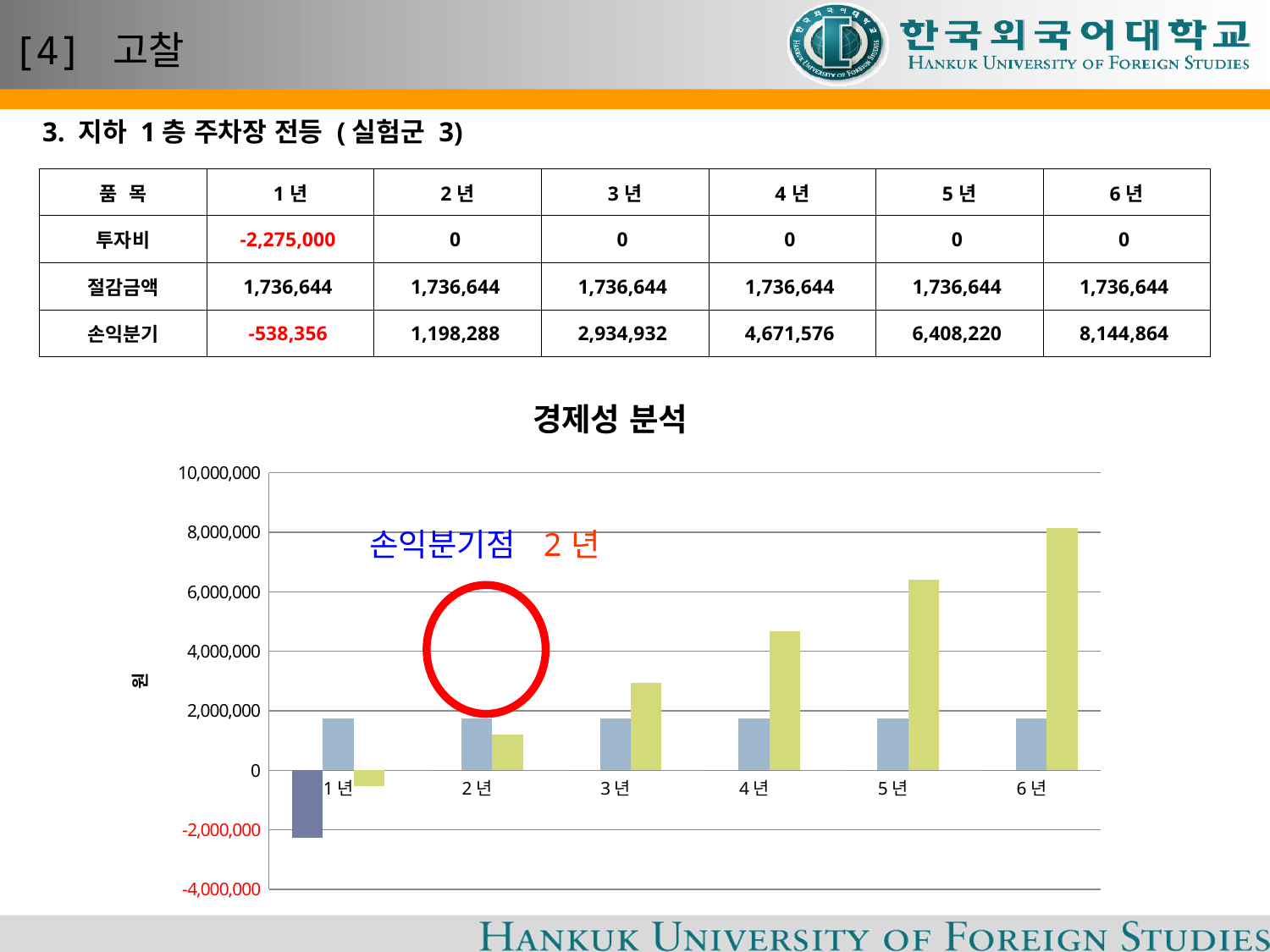
In the 경제성 분석 chart, is the green bar for 6 년 greater or less than 6,000,000? greater In the 경제성 분석 chart, is the green bar for 5 년 greater or less than 4,000,000? greater According to the annotation on the 경제성 분석 chart, at which year is the 손익분기점 (break-even point)? 2 년 In the 경제성 분석 chart, is the green bar for 3 년 greater or less than 4,000,000? less In the 경제성 분석 chart, how many bars extend below zero? 2 In the 경제성 분석 chart, which year has the tallest green bar? 6 년 What kind of chart is shown under the title 경제성 분석? bar chart In the 경제성 분석 chart, do the green bars rise or fall from 1 년 to 6 년? rise In the 경제성 분석 chart, which year has a bar extending below zero to about -2,000,000? 1 년 How many year categories are shown on the x axis of the 경제성 분석 chart? 6 In the 경제성 분석 chart at 2 년, which bar is taller, the light blue bar or the green bar? light blue bar What is the title of the chart on the slide? 경제성 분석